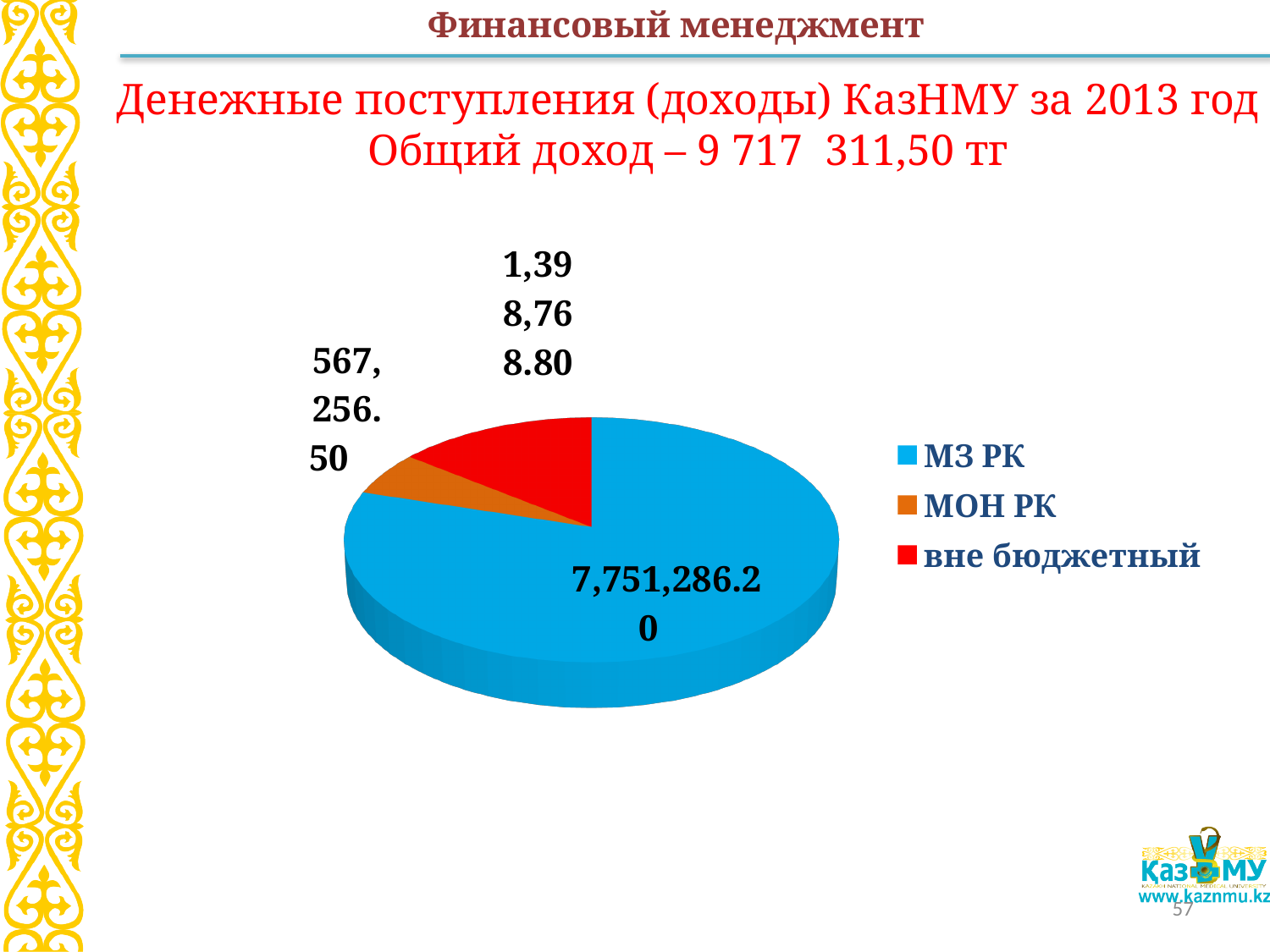
What is the value shown for МОН РК in the pie chart? 567,256.50 What colour is the МЗ РК slice in the pie chart? Blue What is the difference between the values for вне бюджетный and МОН РК? 831,512.30 What is the value shown for МЗ РК in the pie chart? 7,751,286.20 How many slices does the pie chart have? 3 What is the value shown for вне бюджетный in the pie chart? 1,398,768.80 Which category has the smallest slice in the pie chart? МОН РК How many entries does the legend of the pie chart list? 3 Which category has the largest slice in the pie chart? МЗ РК What is the difference between the values for МЗ РК and вне бюджетный? 6,352,517.40 What kind of chart is shown on the slide? Pie chart Which is larger in the pie chart, вне бюджетный or МОН РК? вне бюджетный